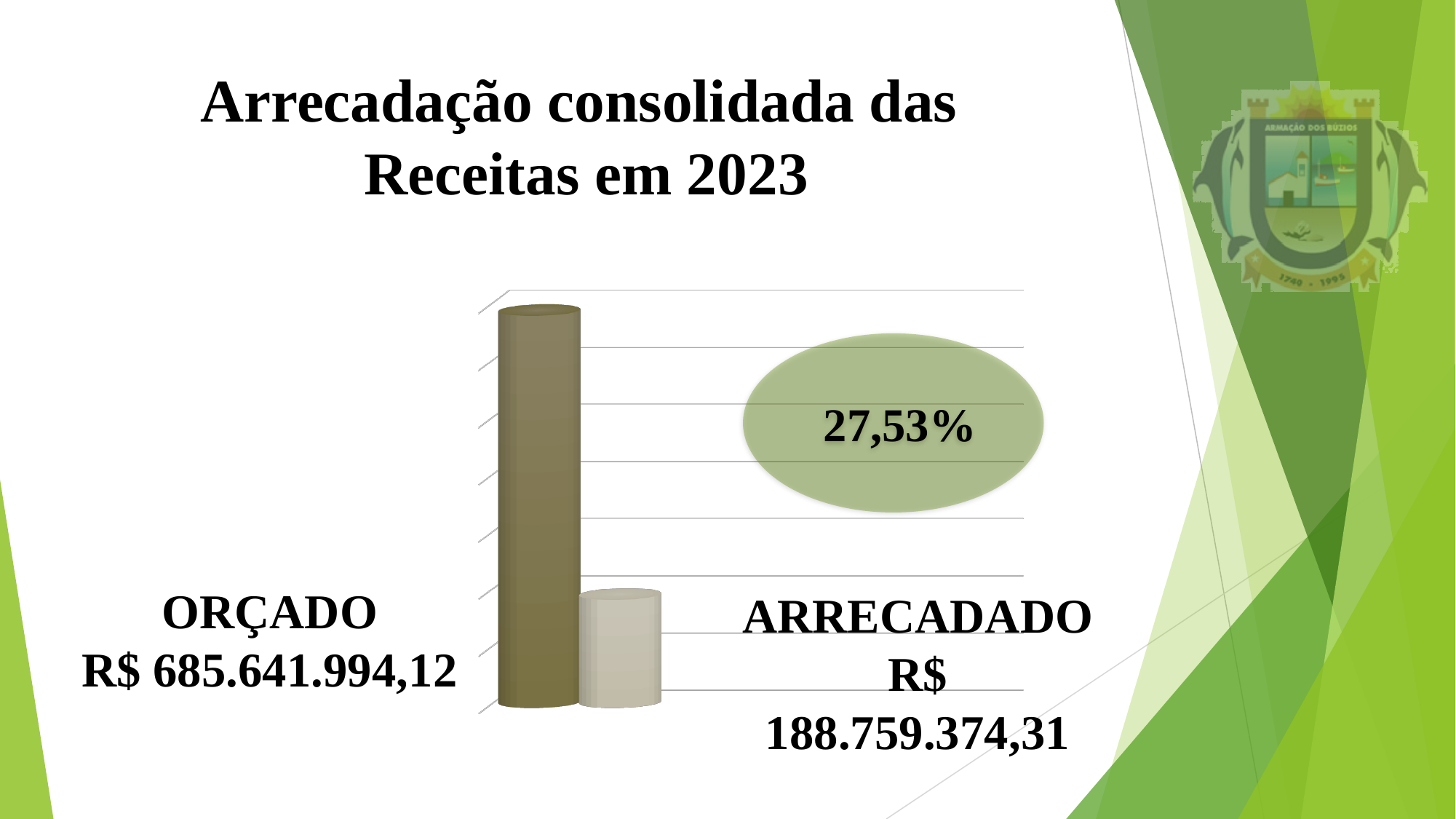
Which category has the higher value, ORÇADO or ARRECADADO? ORÇADO What is the difference between the ORÇADO value and the ARRECADADO value? R$ 496.882.619,81 Which category has the lowest value in the chart? ARRECADADO What kind of chart is shown on the slide? bar chart How many bars are plotted in the chart? 2 What is the value shown for ARRECADADO? R$ 188.759.374,31 Which category has the highest value in the chart? ORÇADO What percentage is shown in the oval next to the bars? 27,53% Is the ARRECADADO bar taller or shorter than the ORÇADO bar? shorter What is the value shown for ORÇADO? R$ 685.641.994,12 What is the title of the chart on the slide? Arrecadação consolidada das Receitas em 2023